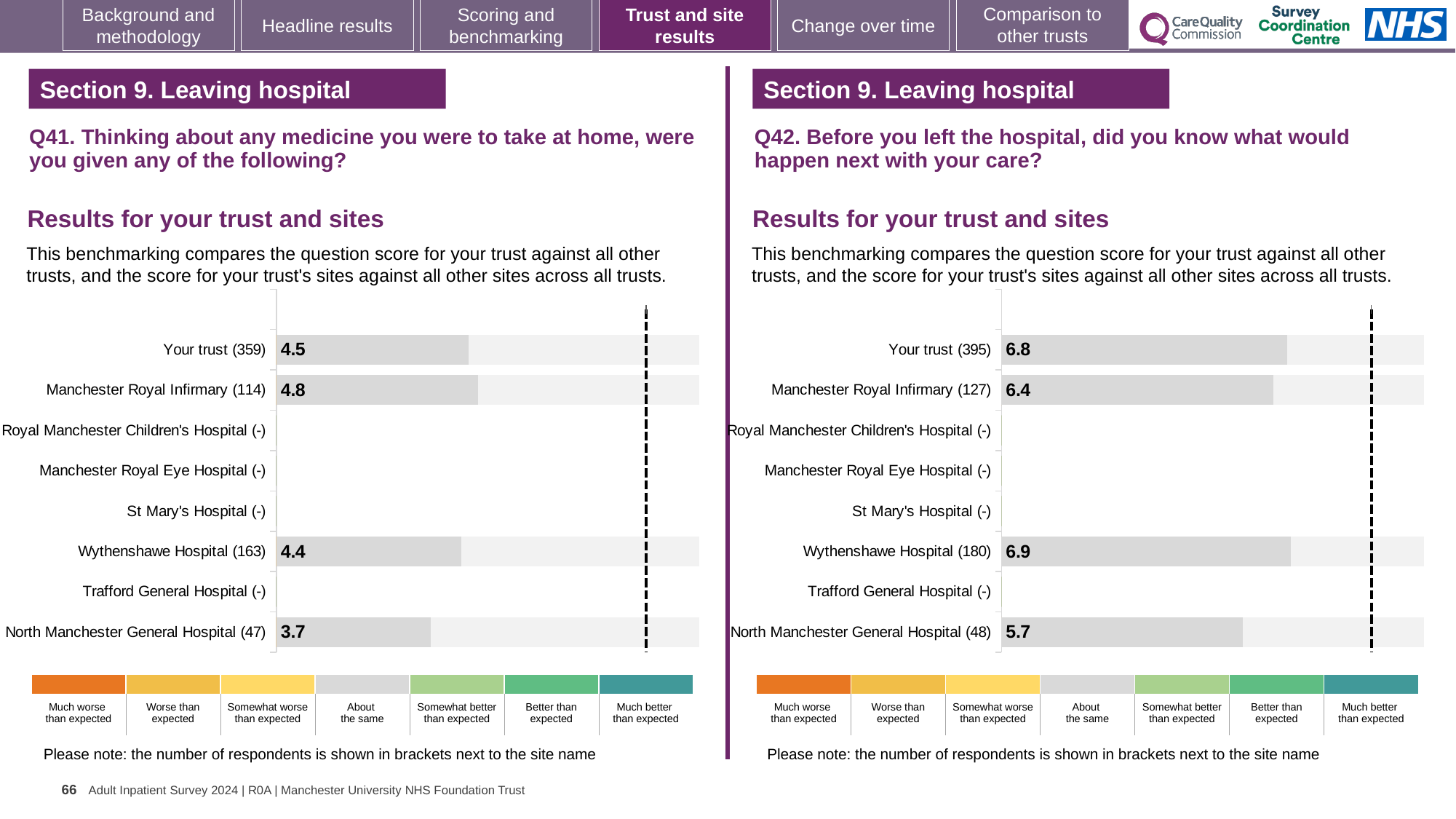
What kind of chart is used on the Q42 chart (right)? Bar chart On the Q41 chart (left), what is the score for Manchester Royal Infirmary (114)? 4.8 On the Q42 chart (right), what is the difference between the scores for Your trust (395) and Manchester Royal Infirmary (127)? 0.4 On the Q42 chart (right), how many rows have a plotted bar with a score? 4 On the Q41 chart (left), which site has the lowest score? North Manchester General Hospital (47) On the Q41 chart (left), which is larger: the score for Your trust (359) or Wythenshawe Hospital (163)? Your trust (359) On the Q42 chart (right), what is the score for North Manchester General Hospital (48)? 5.7 How many site/trust rows are listed on the Q41 chart (left)? 8 On the Q42 chart (right), which site has the highest score? Wythenshawe Hospital (180) On the Q42 chart (right), what is the score for Wythenshawe Hospital (180)? 6.9 On the Q41 chart (left), what is the difference between the scores for Manchester Royal Infirmary (114) and North Manchester General Hospital (47)? 1.1 On the Q41 chart (left), what is the score for Your trust (359)? 4.5